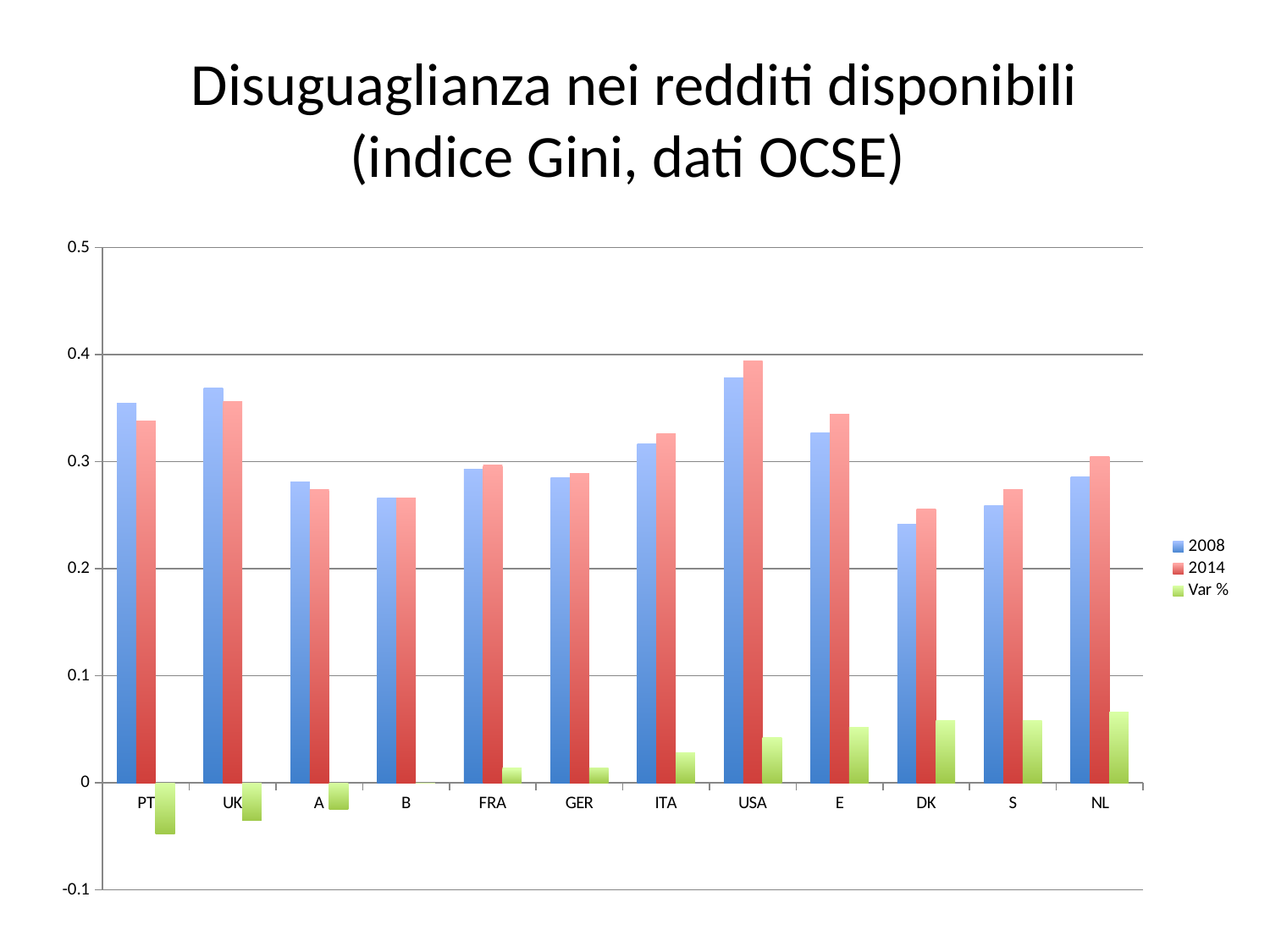
Is the 2008 value for USA greater or less than 0.4? less Which country has the highest value for the 2014 series? USA Is the 2008 value for B greater or less than 0.3? less How many series does the legend list? 3 How many countries are shown on the x axis? 12 Is the 2014 value for ITA greater or less than 0.3? greater What is the title of the chart on the slide? Disuguaglianza nei redditi disponibili (indice Gini, dati OCSE) What kind of chart is shown on the slide? bar chart For ITA, which is larger: the 2008 value or the 2014 value? 2014 Which country has the lowest value for the 2008 series? DK Which country has the lowest value for the Var % series? PT For PT, which is larger: the 2008 value or the 2014 value? 2008